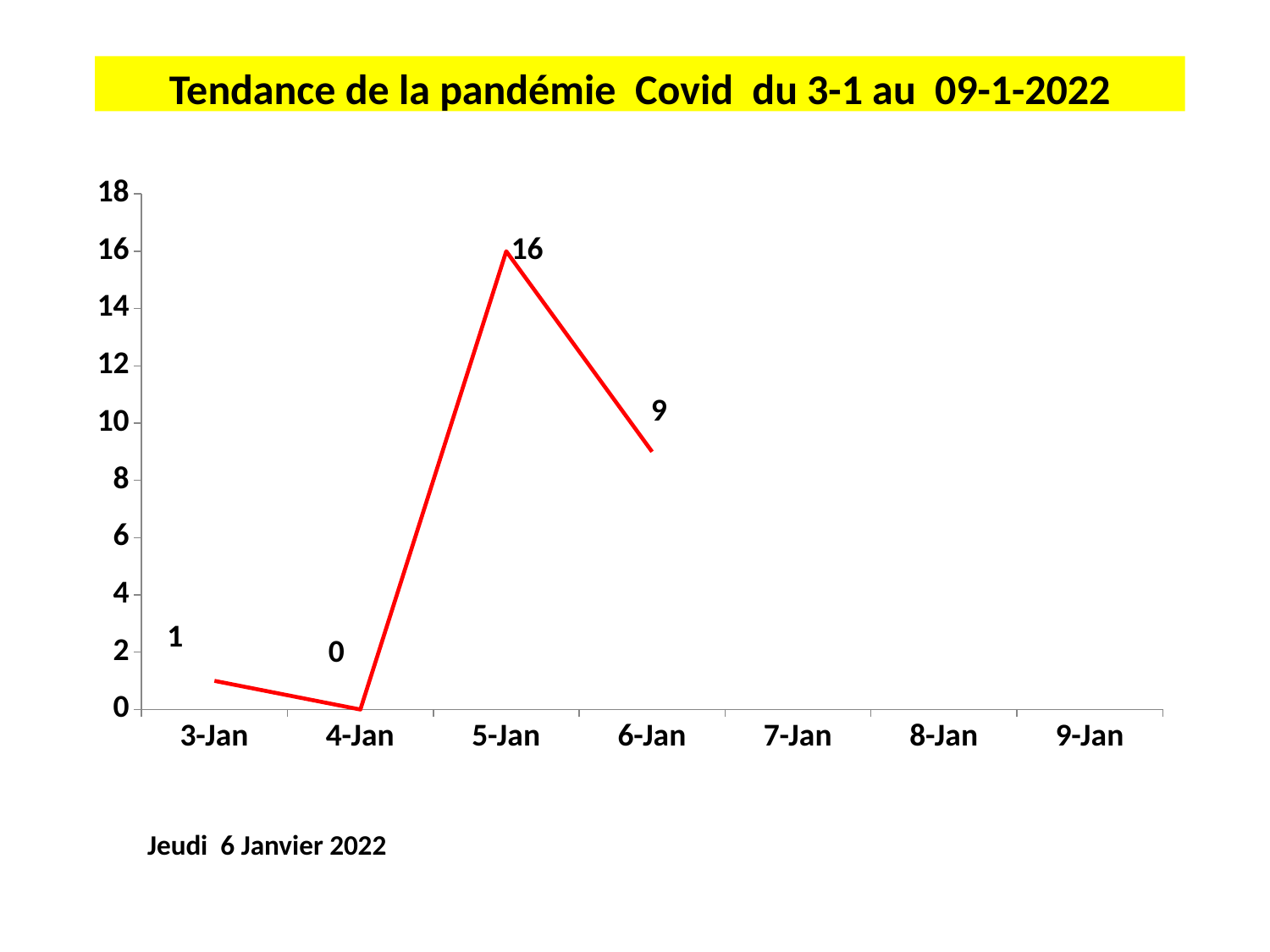
What is the difference between the values for 5-Jan and 6-Jan? 7 What is the value for 6-Jan? 9 Which date has the lowest plotted value? 4-Jan Which date has the highest value? 5-Jan How many dates are labelled on the x axis? 7 Do the values rise or fall from 5-Jan to 6-Jan? fall What kind of chart is shown? line chart What is the value for 3-Jan? 1 What is the value for 4-Jan? 0 Which is larger, the value for 3-Jan or the value for 6-Jan? 6-Jan What is the value for 5-Jan? 16 What is the title of the chart? Tendance de la pandémie Covid du 3-1 au 09-1-2022